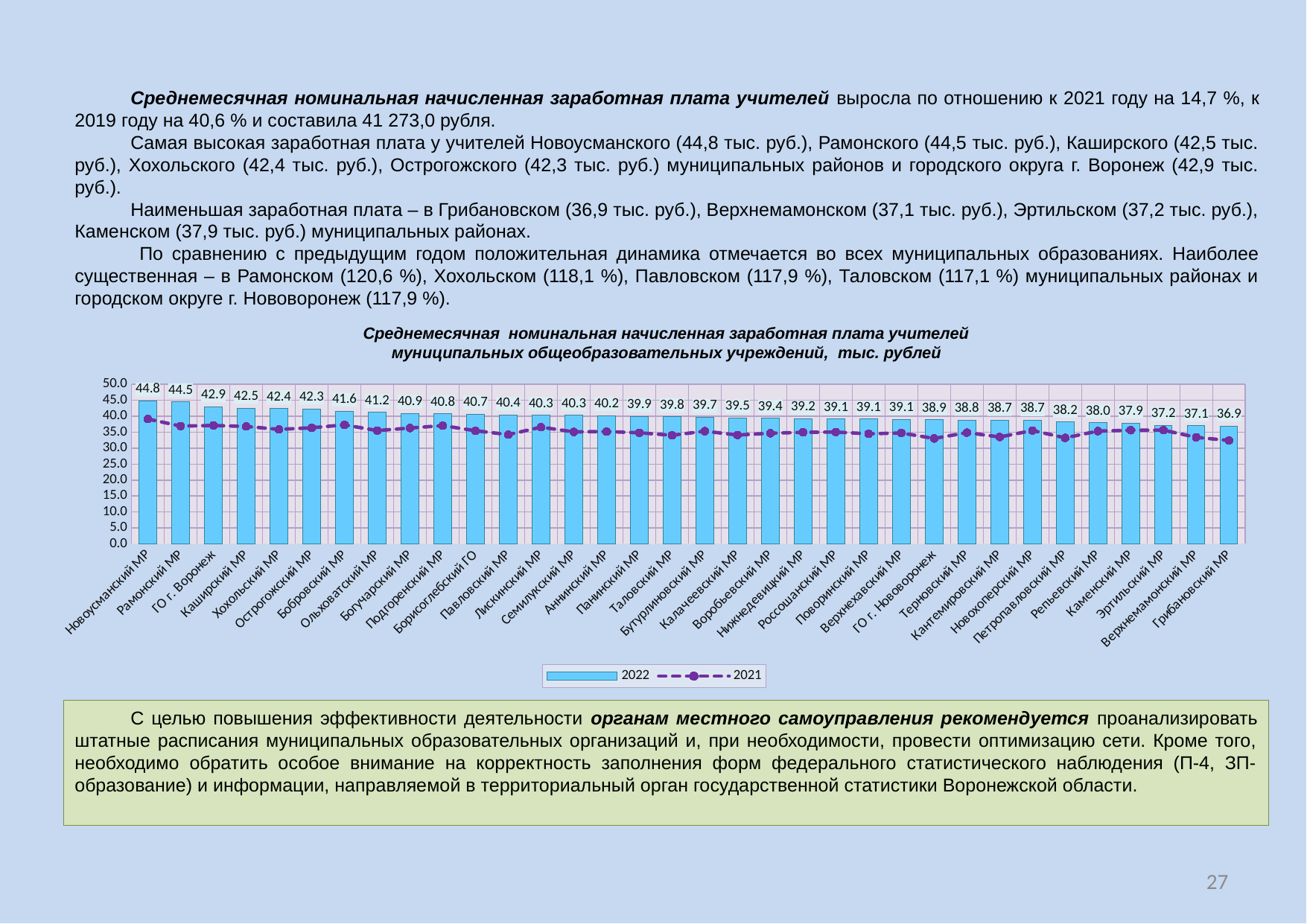
What is the 2022 value for Грибановский МР? 36.9 How many categories are shown on the x axis? 34 Which has a larger 2022 value, Каширский МР or Каменский МР? Каширский МР What is the 2022 value for ГО г. Воронеж? 42.9 Which category has the highest 2022 value? Новоусманский МР What is the 2022 value for Новоусманский МР? 44.8 Which category has the lowest 2022 value? Грибановский МР Is the 2021 value for Новоусманский МР greater or less than 35.0? greater What type of chart is shown on the slide? bar chart (with a line series) How many series does the legend list? 2 What is the difference between the 2022 values for Новоусманский МР and Грибановский МР? 7.9 Do the 2022 bar values rise or fall from left to right along the x axis? fall